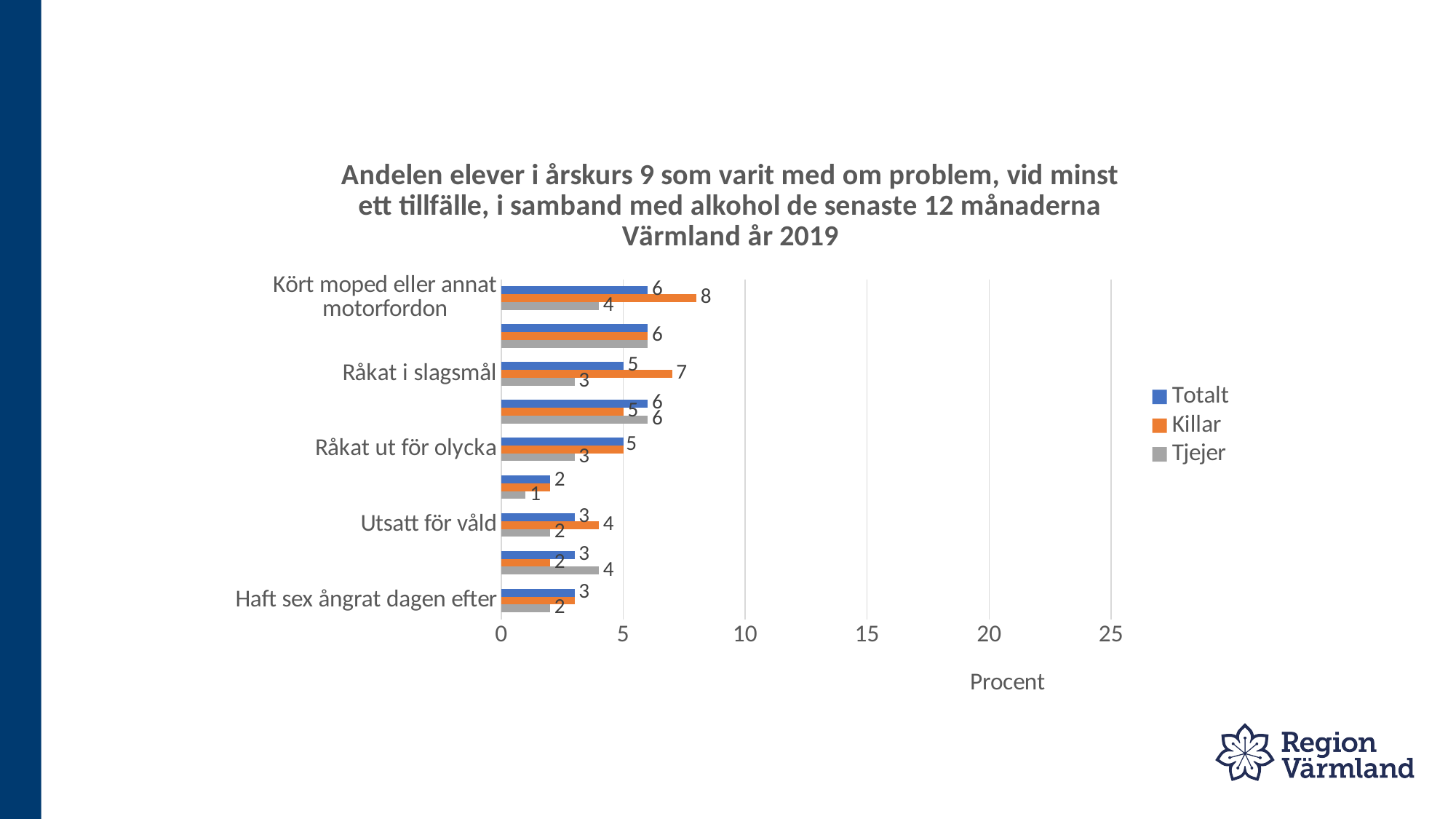
What is the difference between the Killar and Tjejer values for "Råkat i slagsmål"? 4 Among the labelled categories, which has the highest Killar value? Kört moped eller annat motorfordon What is the title of the horizontal axis? Procent What is the Tjejer value for "Råkat i slagsmål"? 3 How many series does the legend list? 3 Which is larger for "Utsatt för våld": the Killar value or the Tjejer value? Killar What is the Totalt value for "Utsatt för våld"? 3 What is the Tjejer value for "Haft sex ångrat dagen efter"? 2 Is the Killar value for "Kört moped eller annat motorfordon" greater or less than 10? less What kind of chart is shown on the slide? Bar chart What is the difference between the Killar and Tjejer values for "Kört moped eller annat motorfordon"? 4 What is the Killar value for "Kört moped eller annat motorfordon"? 8